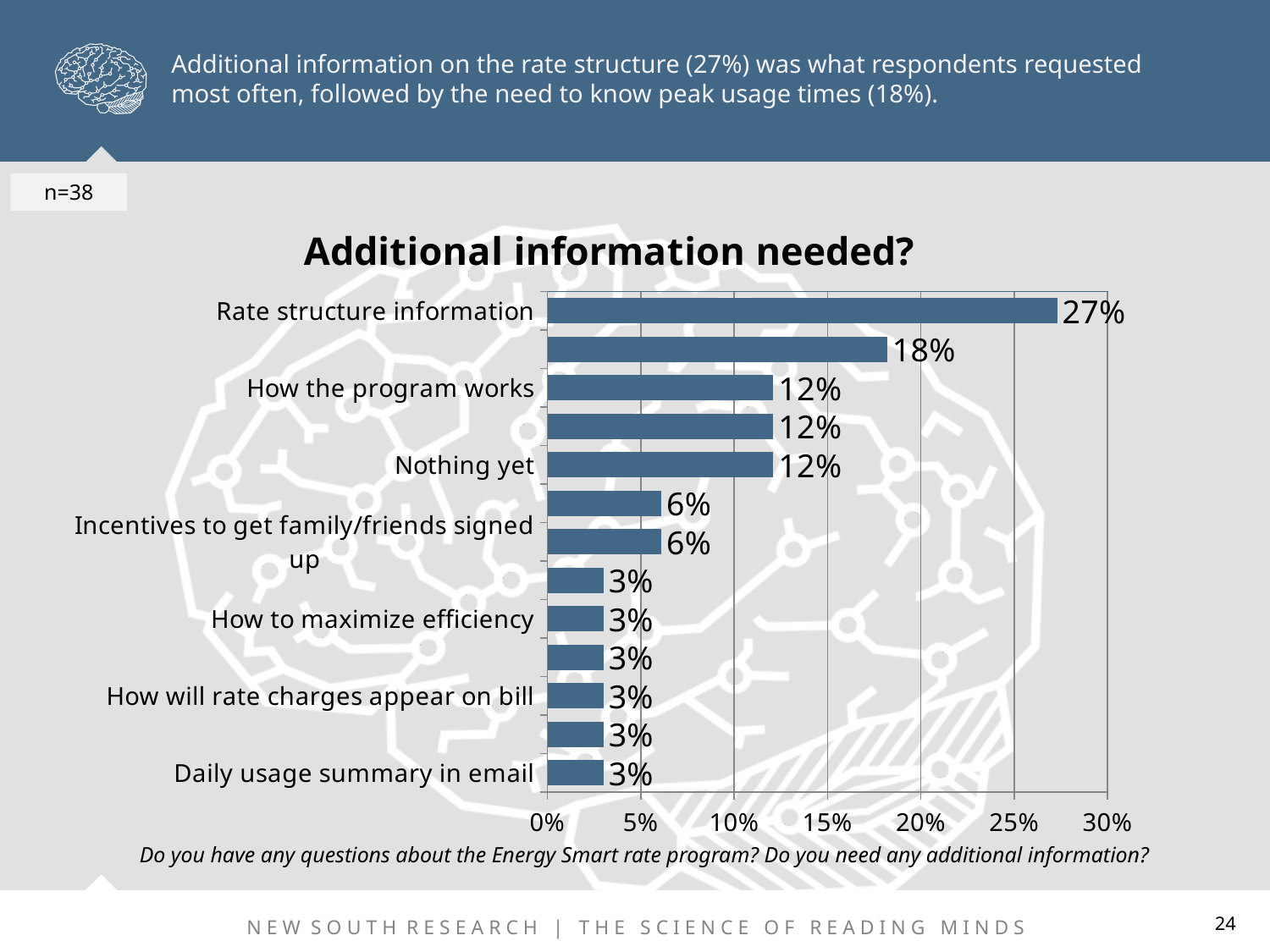
Which is larger, the value for Incentives to get family/friends signed up or the value for How will rate charges appear on bill? Incentives to get family/friends signed up What is the value for Daily usage summary in email? 3% What is the value for How the program works? 12% What is the difference between the values for Rate structure information and How the program works? 15% What is the difference between the values for Nothing yet and How to maximize efficiency? 9% How many bars are plotted in the chart? 13 What is the title of the chart? Additional information needed? What is the value for Rate structure information? 27% Which category has the highest value? Rate structure information What kind of chart is shown on the slide? Bar chart What is the value for Incentives to get family/friends signed up? 6% What is the value for Nothing yet? 12%